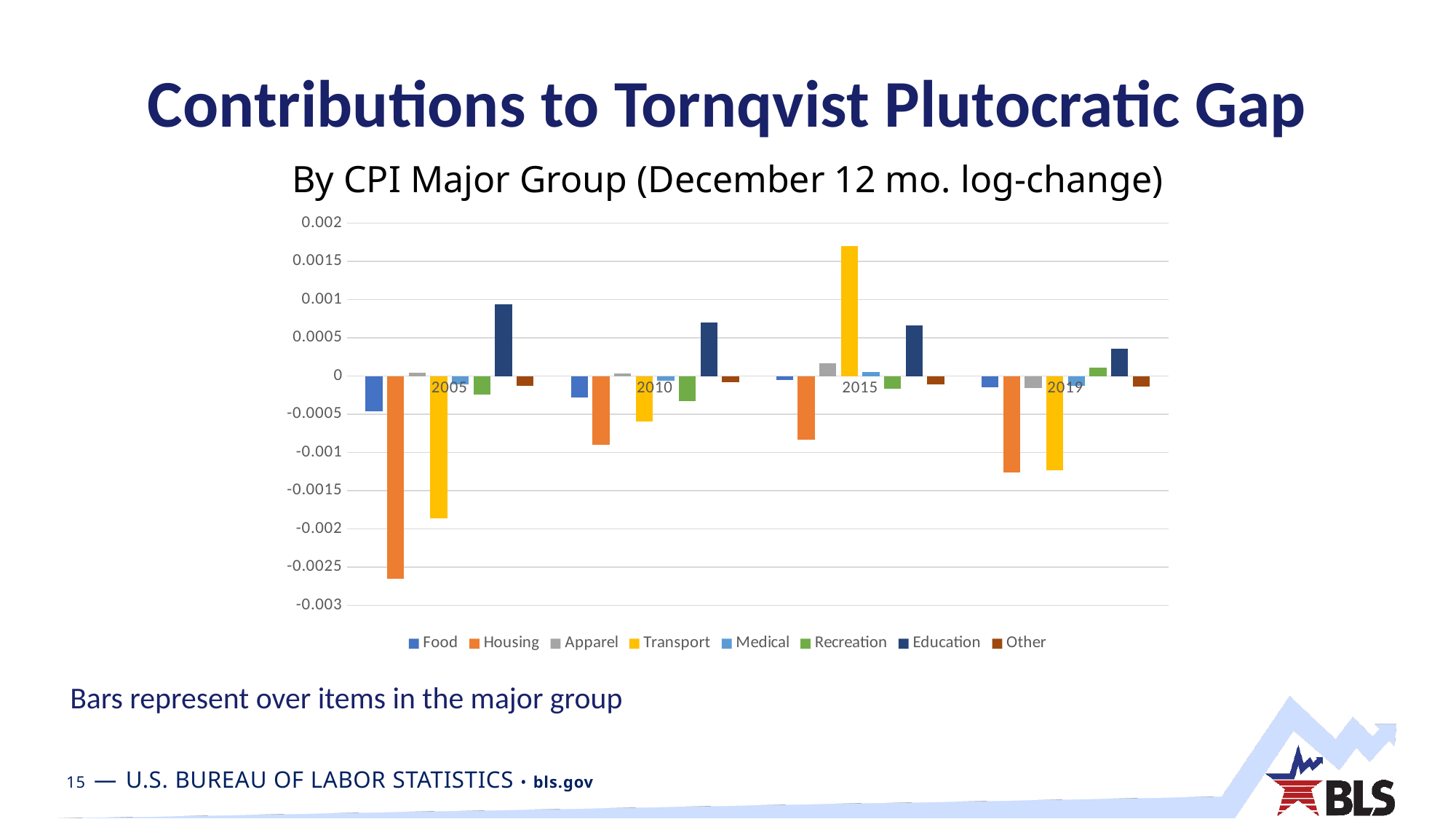
Which series has the highest bar in 2005? Education Is the value for Transport in 2005 greater or less than -0.0015? less How many years (categories) are shown on the x axis of the chart? 4 How many series does the chart's legend list? 8 What is the subtitle of the chart below the main title? By CPI Major Group (December 12 mo. log-change) Is the value for Housing in 2005 greater or less than -0.0025? less Which is larger, the Education value in 2005 or the Education value in 2019? 2005 Which series has the lowest (most negative) bar in 2005? Housing What kind of chart is shown on the slide? bar chart Is the value for Transport in 2015 greater or less than 0.0015? greater Which series has the highest bar in 2015? Transport Does the Education contribution rise or fall across the years from 2005 to 2019? fall